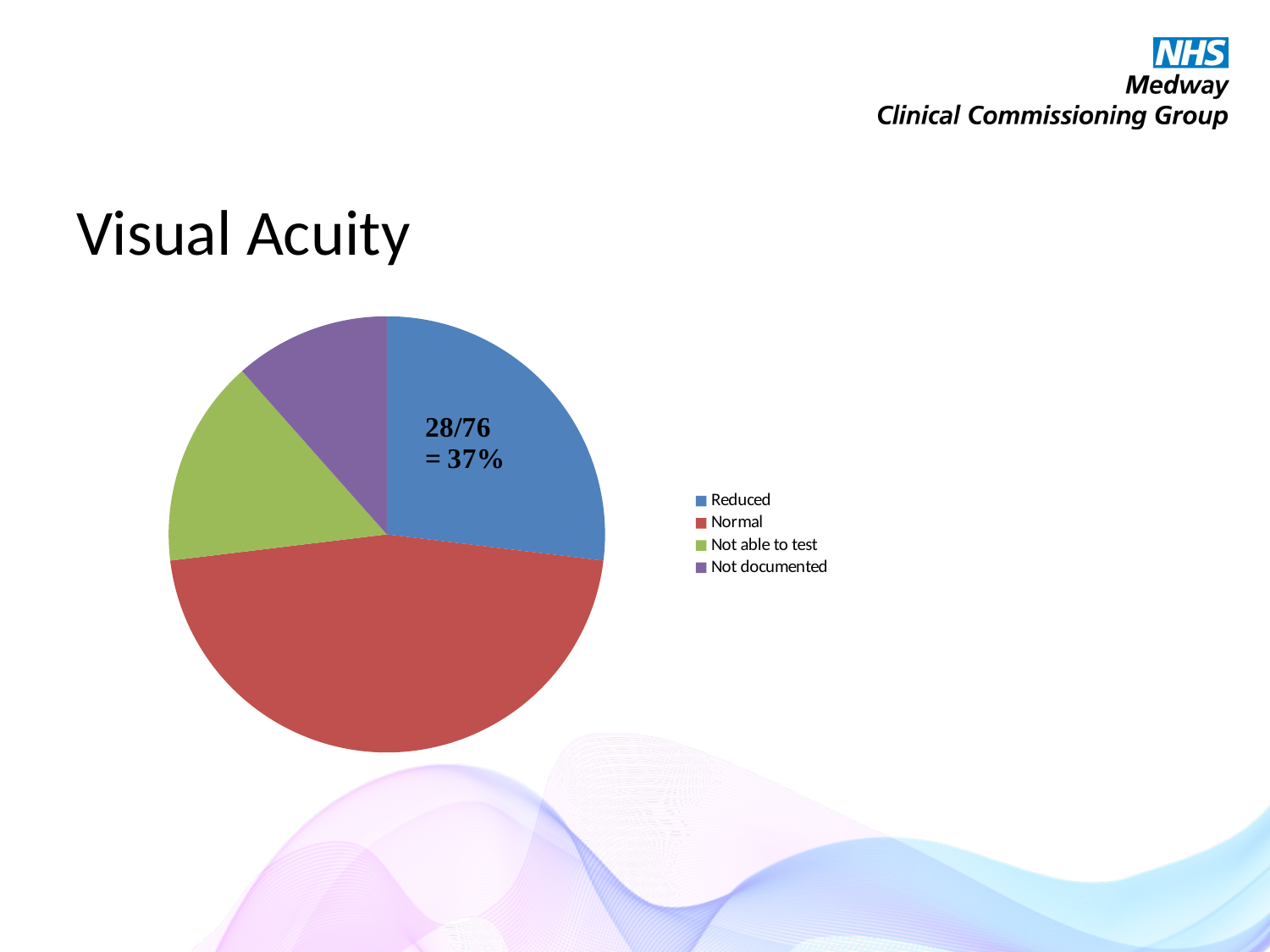
What kind of chart is shown on the slide? Pie chart How many slices does the pie chart have? 4 Which category has the smallest slice in the pie chart? Not documented Which category has the largest slice in the pie chart? Normal What colour is the Normal slice in the pie chart? Red Which slice is larger in the pie chart, Not able to test or Not documented? Not able to test What label is printed on the Reduced slice of the pie chart? 28/76 = 37% How many entries does the legend of the pie chart list? 4 What is the title of the slide containing the pie chart? Visual Acuity Which slice is larger in the pie chart, Normal or Reduced? Normal